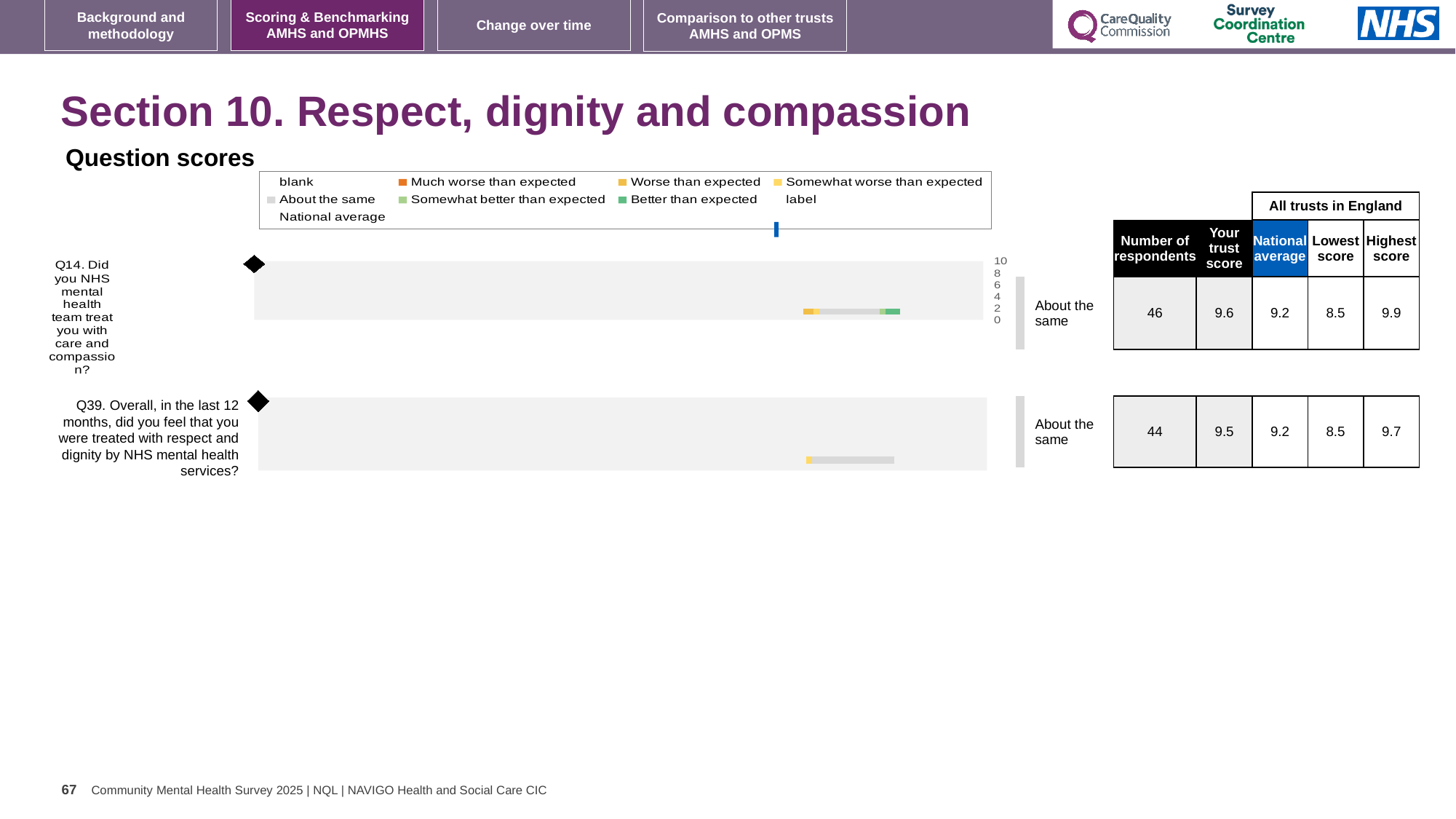
Which question has the higher trust score, Q14 or Q39? Q14 What is the national average for Q14 shown alongside its chart? 9.2 What is the trust score for Q39 shown alongside its chart? 9.5 In the chart legend, which colour represents 'Much worse than expected'? orange In the chart legend, which colour represents 'Better than expected'? green What benchmark rating is shown next to the Q39 chart? About the same How many survey questions are plotted in the question scores charts? 2 What is the highest score across all trusts in England for Q39? 9.7 What benchmark rating is shown next to the Q14 chart? About the same What is the difference between the trust score and the national average for Q14? 0.4 What is the trust score for Q14 shown alongside its chart? 9.6 What kind of chart is used to show the question scores for Q14 and Q39? bar chart